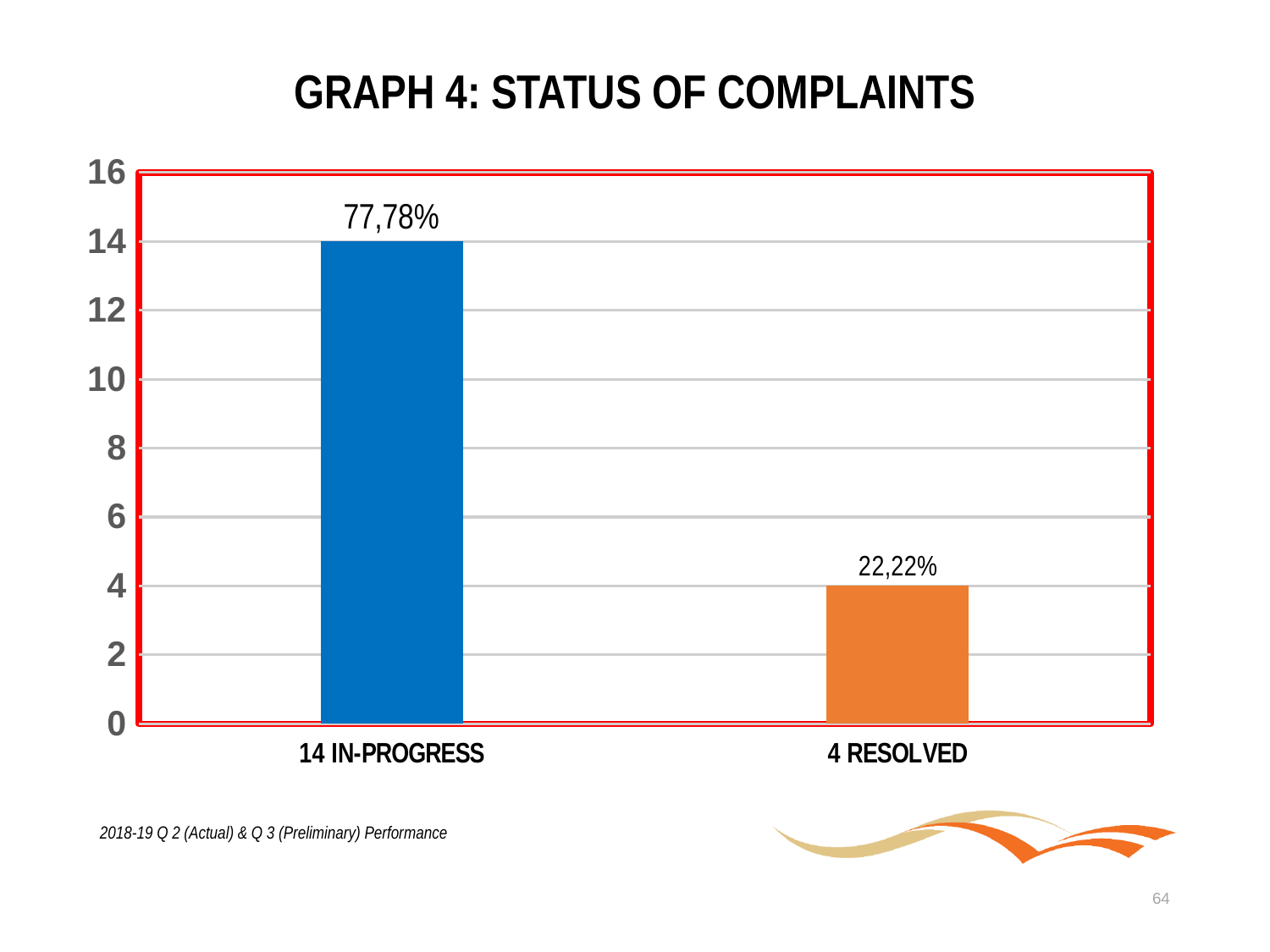
Which is larger, the bar for 14 IN-PROGRESS or the bar for 4 RESOLVED? 14 IN-PROGRESS What is the title of the chart? GRAPH 4: STATUS OF COMPLAINTS What kind of chart is shown on the slide? bar chart What percentage label is shown above the 14 IN-PROGRESS bar? 77,78% Which category has the highest bar? 14 IN-PROGRESS How many categories are plotted in the chart? 2 Which category has the lowest bar? 4 RESOLVED What is the difference between the 14 IN-PROGRESS bar and the 4 RESOLVED bar on the vertical axis? 10 Is the value for 4 RESOLVED greater or less than 6? less What value on the vertical axis does the 14 IN-PROGRESS bar reach? 14 What value on the vertical axis does the 4 RESOLVED bar reach? 4 What percentage label is shown above the 4 RESOLVED bar? 22,22%